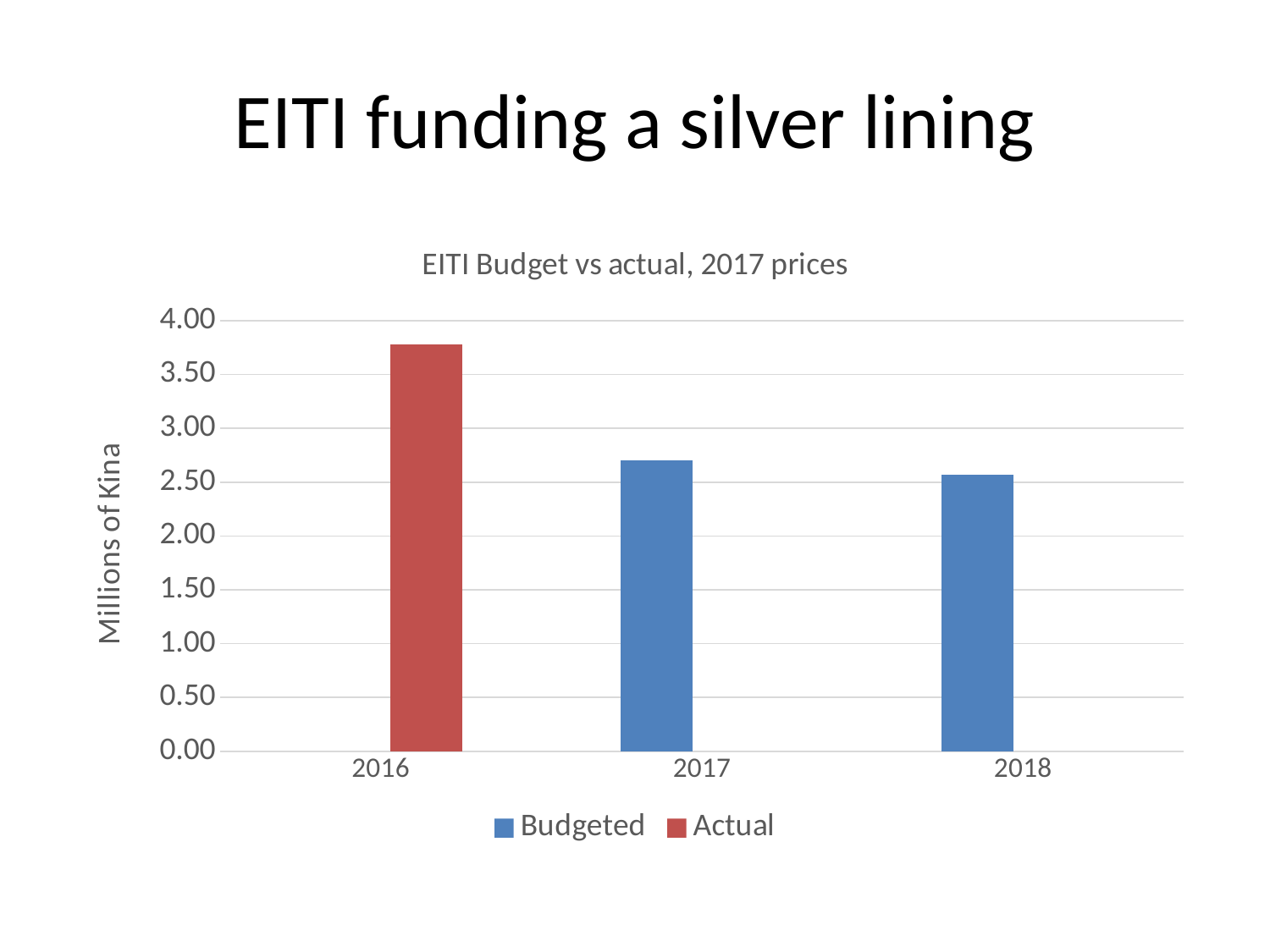
How many years are shown on the x axis? 3 How many series does the legend list? 2 Which year has the tallest bar? 2016 Is the Budgeted value for 2017 greater or less than 3.00? less Which year has the shortest bar? 2018 What is the label on the vertical axis of the chart? Millions of Kina What kind of chart is shown on the slide? bar chart Do the bar values rise or fall from 2016 to 2018? fall What is the title of the chart? EITI Budget vs actual, 2017 prices Is the Actual value for 2016 greater or less than 3.50? greater Is the Budgeted value for 2018 greater or less than 2.00? greater